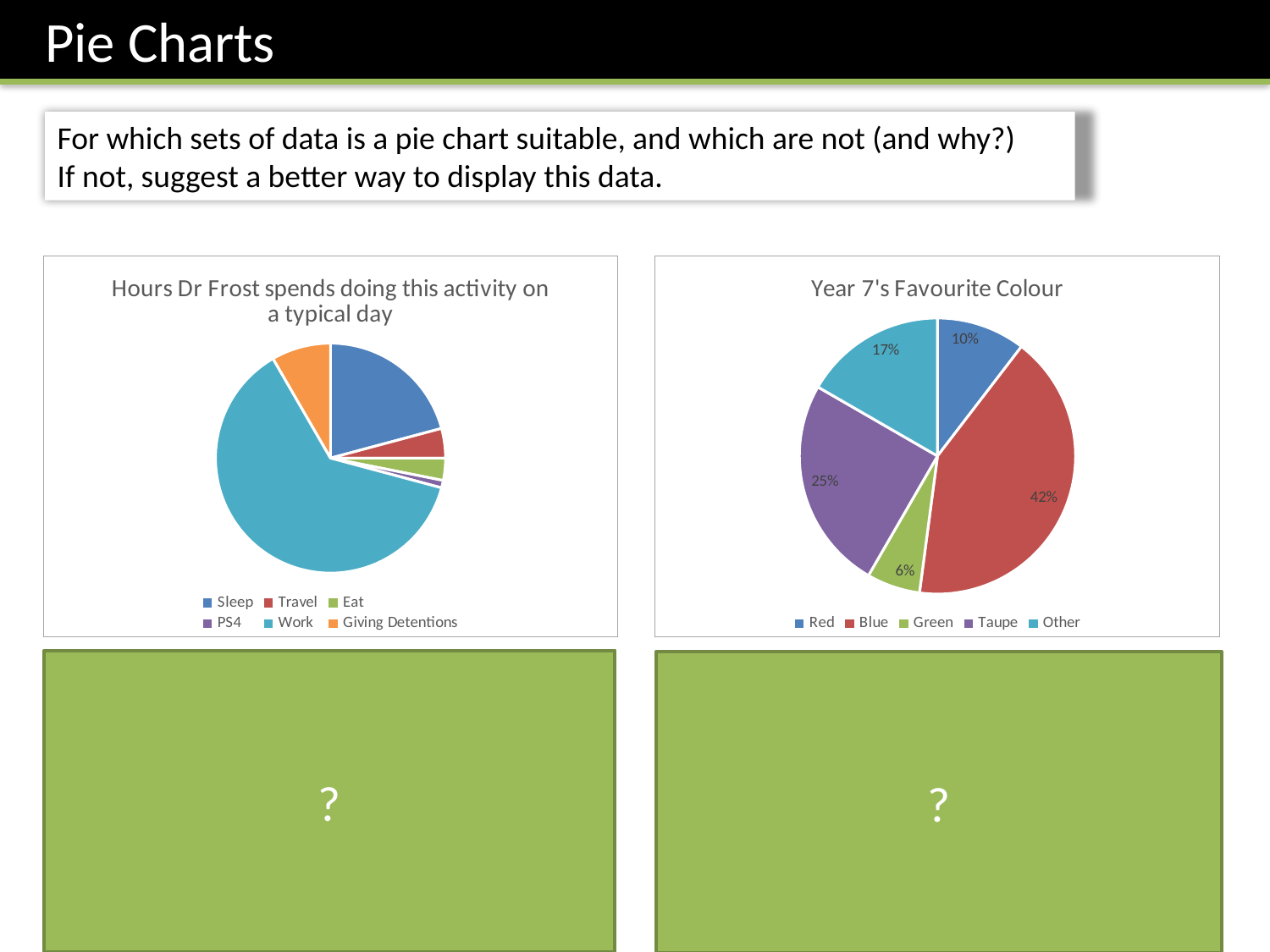
In the 'Hours Dr Frost spends doing this activity on a typical day' chart, which activity has the largest slice? Work How many categories does the legend of the 'Hours Dr Frost spends doing this activity on a typical day' chart list? 6 In the 'Year 7's Favourite Colour' chart, which colour has the smallest slice? Green In the 'Year 7's Favourite Colour' chart, which is larger, Red or Other? Other In the 'Year 7's Favourite Colour' chart, what percentage is shown for Taupe? 25% In the 'Year 7's Favourite Colour' chart, what share of the pie is Blue? 42% In the 'Hours Dr Frost spends doing this activity on a typical day' chart, which is larger, Sleep or Travel? Sleep In the 'Year 7's Favourite Colour' chart, what percentage is shown for Green? 6% In the 'Year 7's Favourite Colour' chart, which colour has the largest slice? Blue What kind of chart is the 'Year 7's Favourite Colour' chart? pie chart In the 'Year 7's Favourite Colour' chart, what is the difference between the Blue and Taupe percentages? 17% How many categories does the legend of the 'Year 7's Favourite Colour' chart list? 5